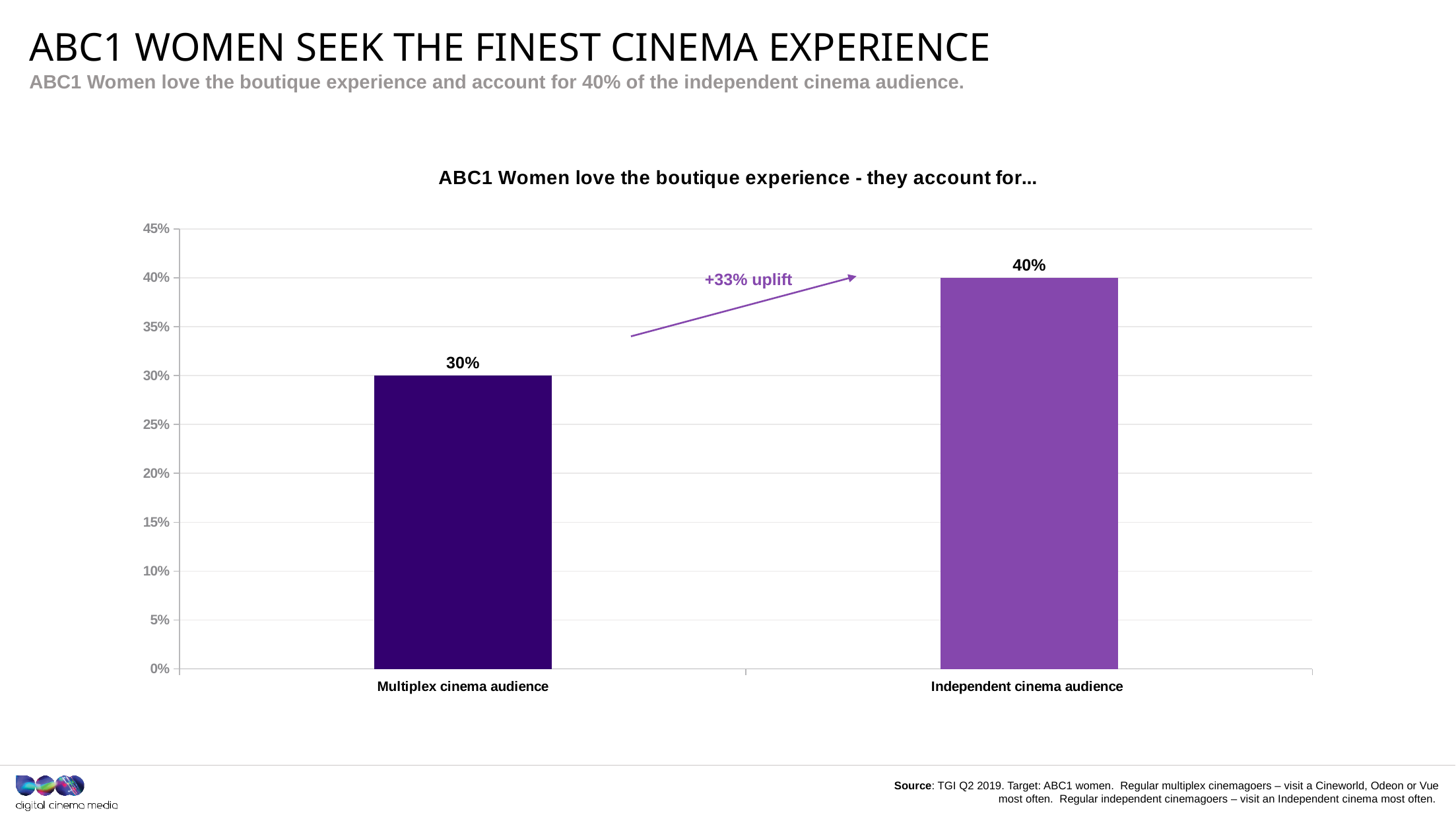
What is the difference between the Independent cinema audience and Multiplex cinema audience values? 10% What is the value for Independent cinema audience? 40% What kind of chart is shown on the slide? Bar chart How many categories are shown on the chart? 2 What is the title of the chart? ABC1 Women love the boutique experience - they account for... Do the values rise or fall from Multiplex cinema audience to Independent cinema audience? Rise Is the value for Multiplex cinema audience greater or less than 35%? less What uplift is annotated on the chart between the two bars? +33% uplift Which is larger, the value for Multiplex cinema audience or Independent cinema audience? Independent cinema audience Which category has the highest value? Independent cinema audience What is the value for Multiplex cinema audience? 30% Which category has the lowest value? Multiplex cinema audience